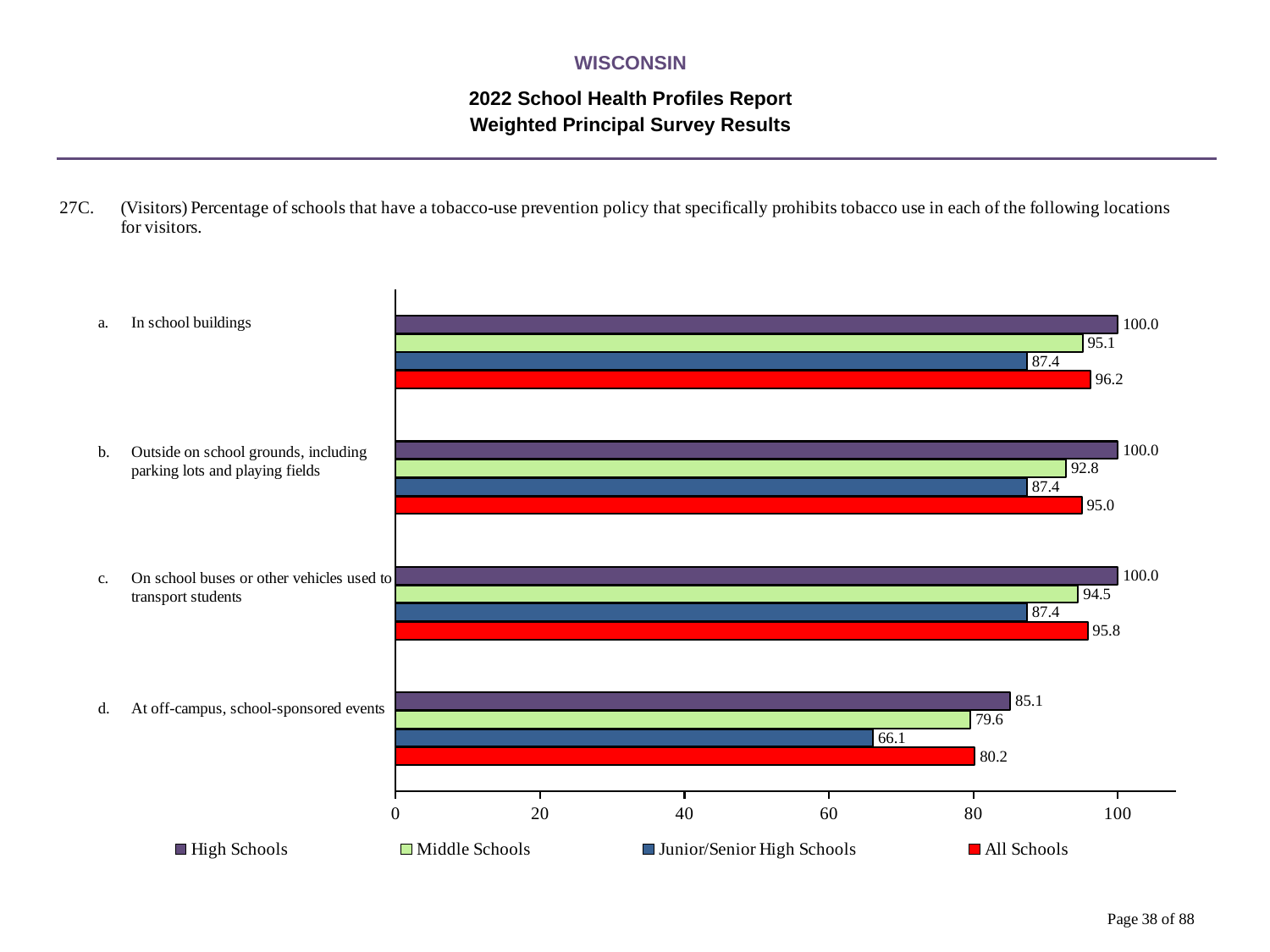
Which colour represents All Schools in the legend? Red How many series does the legend list? 4 What is the value for High Schools for 'In school buildings'? 100.0 Which location has the highest value for Middle Schools? In school buildings Which location has the lowest value for All Schools? At off-campus, school-sponsored events What kind of chart is shown on the slide? Bar chart What is the value for Junior/Senior High Schools for 'At off-campus, school-sponsored events'? 66.1 What is the difference between the High Schools and Junior/Senior High Schools values for 'At off-campus, school-sponsored events'? 19.0 What is the value for All Schools for 'Outside on school grounds, including parking lots and playing fields'? 95.0 For 'In school buildings', which is larger: the Middle Schools value or the All Schools value? All Schools How many locations (categories) are shown on the chart? 4 What is the value for Middle Schools for 'On school buses or other vehicles used to transport students'? 94.5